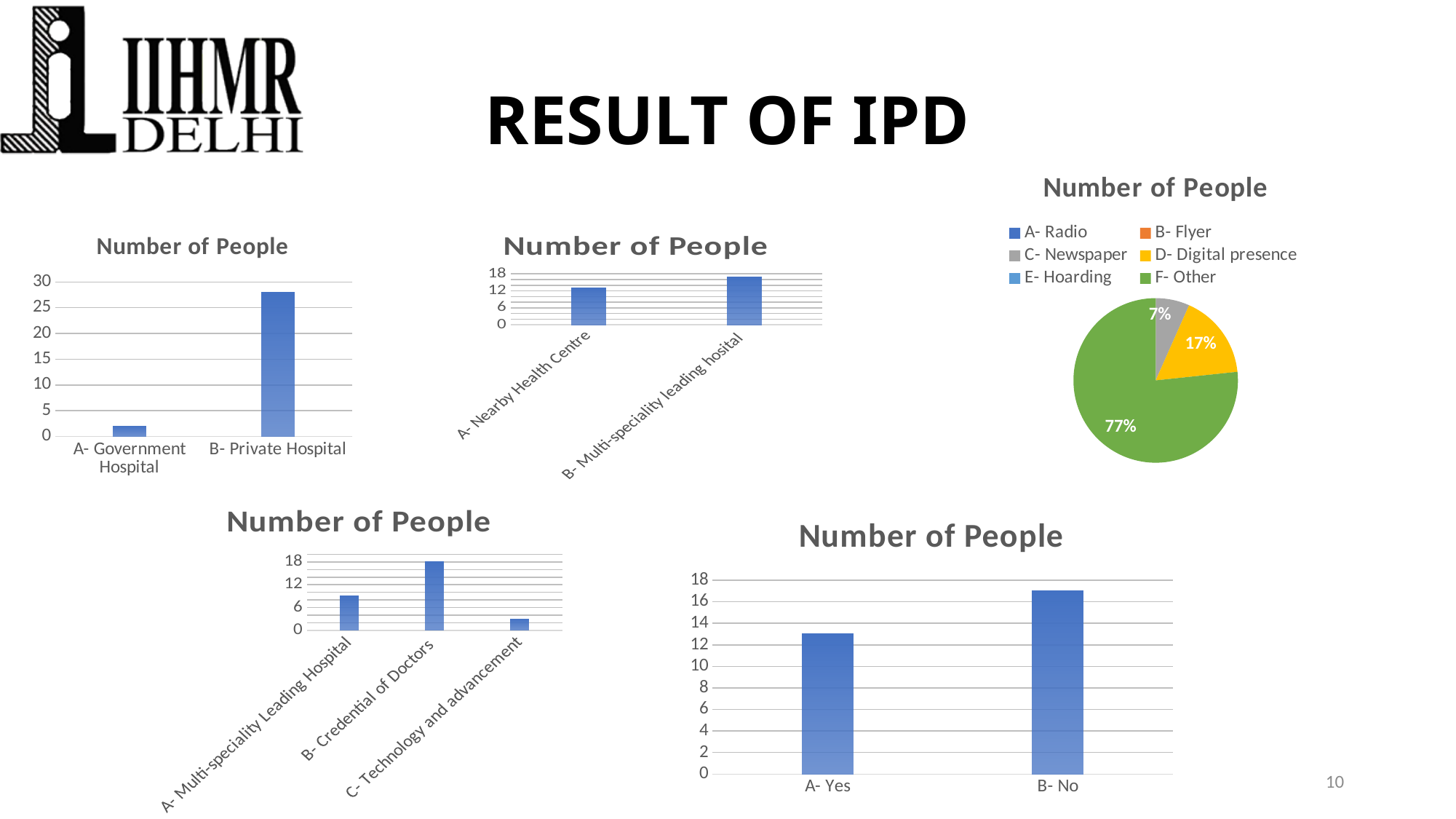
How many entries does the legend of the pie chart on the top right list? 6 In the pie chart on the top right, what share does F- Other have? 77% In the pie chart on the top right, what share does D- Digital presence have? 17% In the top-left chart, is the value for A- Government Hospital greater or less than 5? less In the pie chart on the top right, what is the difference between the shares of F- Other and C- Newspaper? 70% How many categories are shown in the bottom-left bar chart? 3 In the bottom-left bar chart, which category has the lowest value? C- Technology and advancement In the top-left chart, is the value for B- Private Hospital greater or less than 25? greater In the top-middle bar chart, is the value for A- Nearby Health Centre greater or less than 18? less In the bottom-right chart, which is larger: A- Yes or B- No? B- No In the top-middle bar chart, which is larger: A- Nearby Health Centre or B- Multi-speciality leading hosital? B- Multi-speciality leading hosital In the top-left chart, which category has the highest value? B- Private Hospital